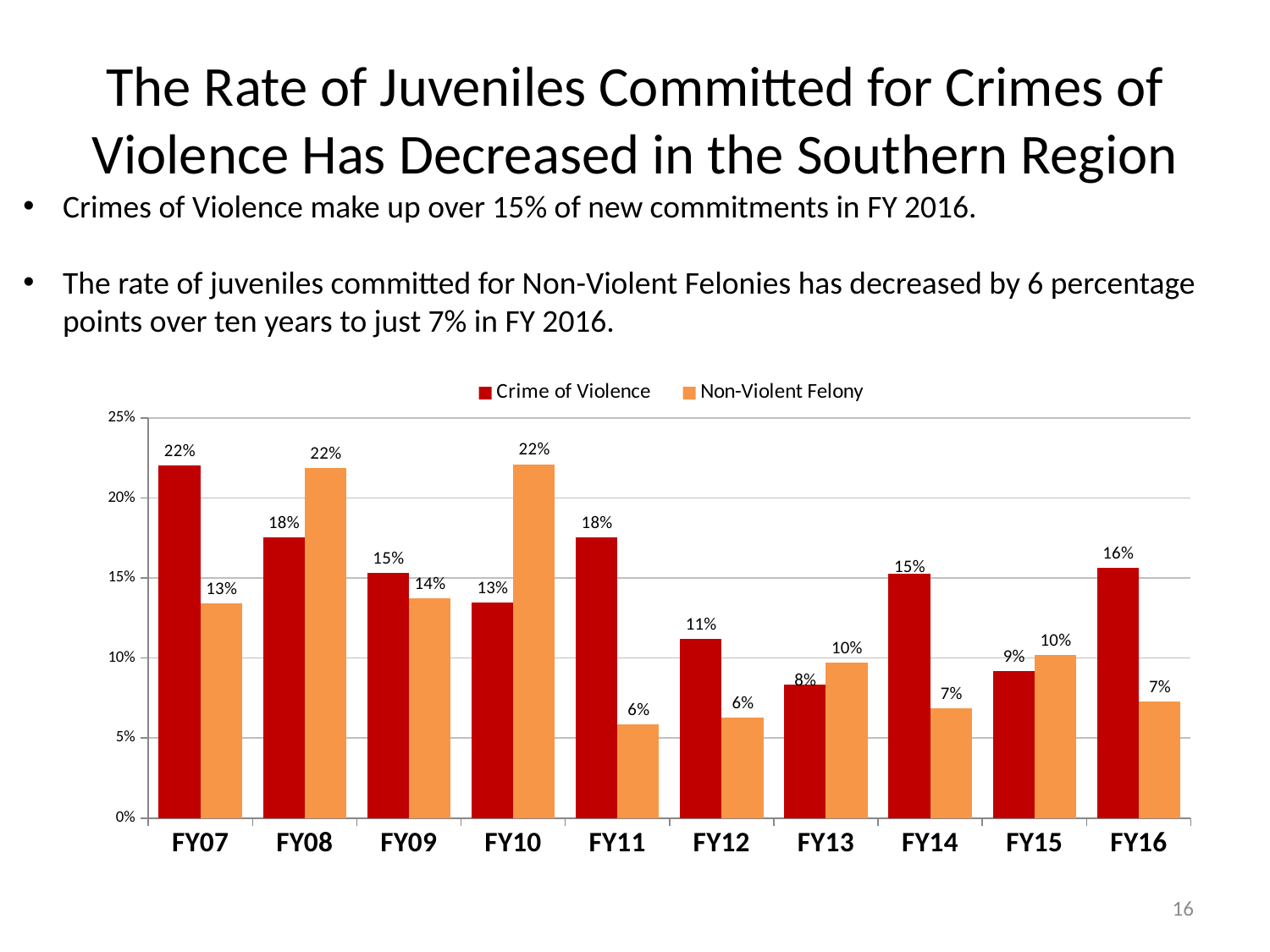
How many fiscal years are shown on the x axis? 10 What is the Non-Violent Felony value for FY13? 10% Is the Non-Violent Felony value for FY10 greater or less than 20%? greater What is the difference between the Crime of Violence and Non-Violent Felony values in FY16? 9 percentage points What kind of chart is shown on the slide? Bar chart What is the Crime of Violence value for FY12? 11% In FY11, which is larger: Crime of Violence or Non-Violent Felony? Crime of Violence What is the Crime of Violence value for FY07? 22% In which fiscal year is the Crime of Violence value highest? FY07 In which fiscal year is the Crime of Violence value lowest? FY13 What is the Non-Violent Felony value for FY16? 7% How many series does the legend list? 2